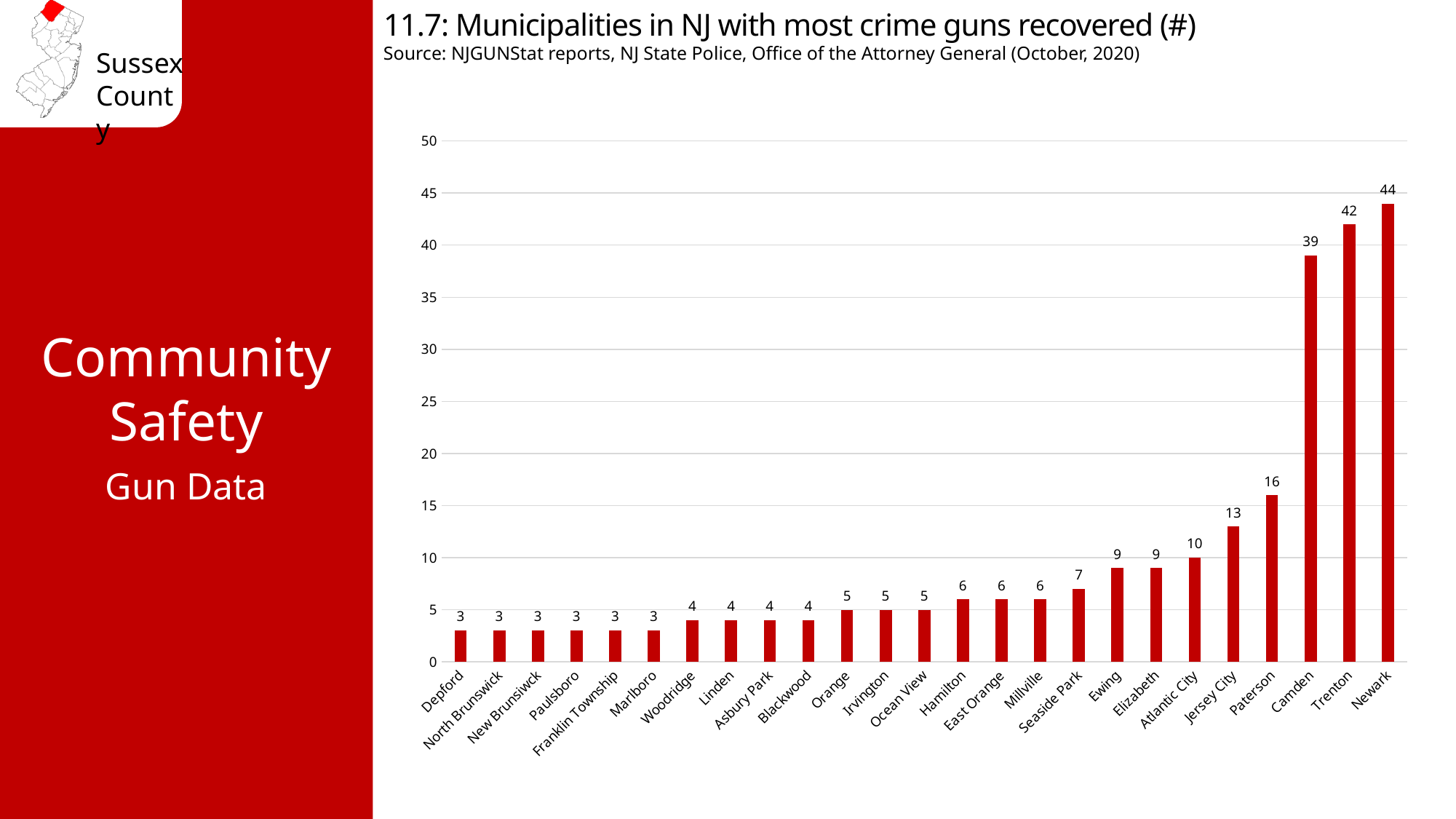
What is the value for Atlantic City? 10 Do the values rise or fall moving from left to right along the x axis? Rise What is the difference between the values for Newark and Trenton? 2 What is the value shown for Camden? 39 Which has a larger value, Jersey City or Elizabeth? Jersey City How many crime guns were recovered in Paterson? 16 How many municipalities are shown on the chart? 25 What kind of chart is shown on the slide? Bar chart Is the value for Trenton greater or less than 40? greater How many crime guns were recovered in Newark? 44 What is the difference between the values for Camden and Paterson? 23 Which municipality has the highest number of crime guns recovered? Newark